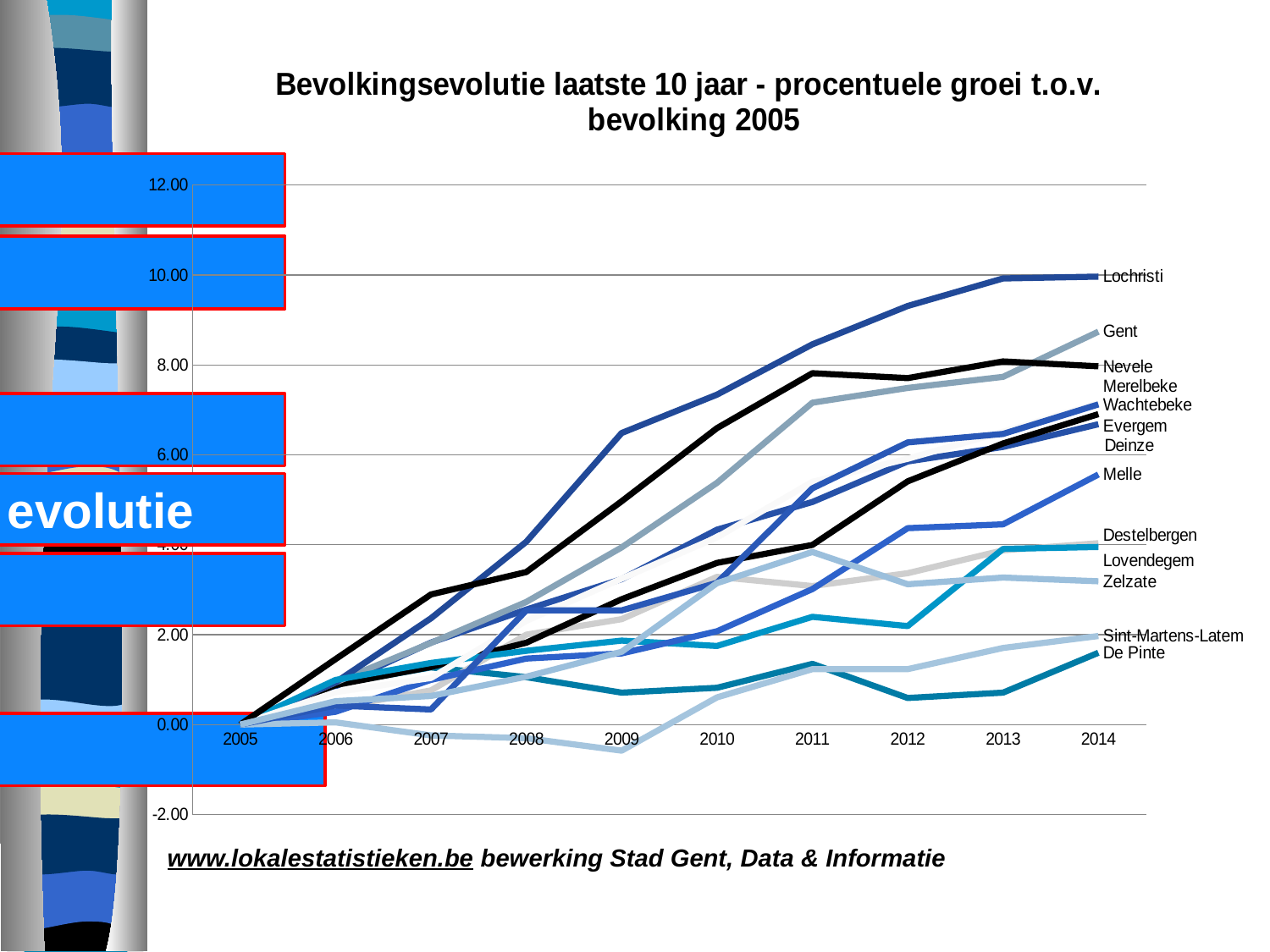
In 2014, which is higher: Gent or Nevele? Gent Is the value for Lochristi in 2009 greater or less than 6.00? greater Does the line for Lochristi rise or fall from 2005 to 2014? rise What kind of chart is shown on the slide? line chart Is the value for Gent in 2014 greater or less than 8.00? greater Is the value for De Pinte in 2014 greater or less than 2.00? less Which municipality has the lowest value in 2014? De Pinte What is the title of the chart? Bevolkingsevolutie laatste 10 jaar - procentuele groei t.o.v. bevolking 2005 How many years are plotted along the x axis? 10 How many municipalities (series) are labelled on the chart? 13 Which municipality has the highest value in 2014? Lochristi